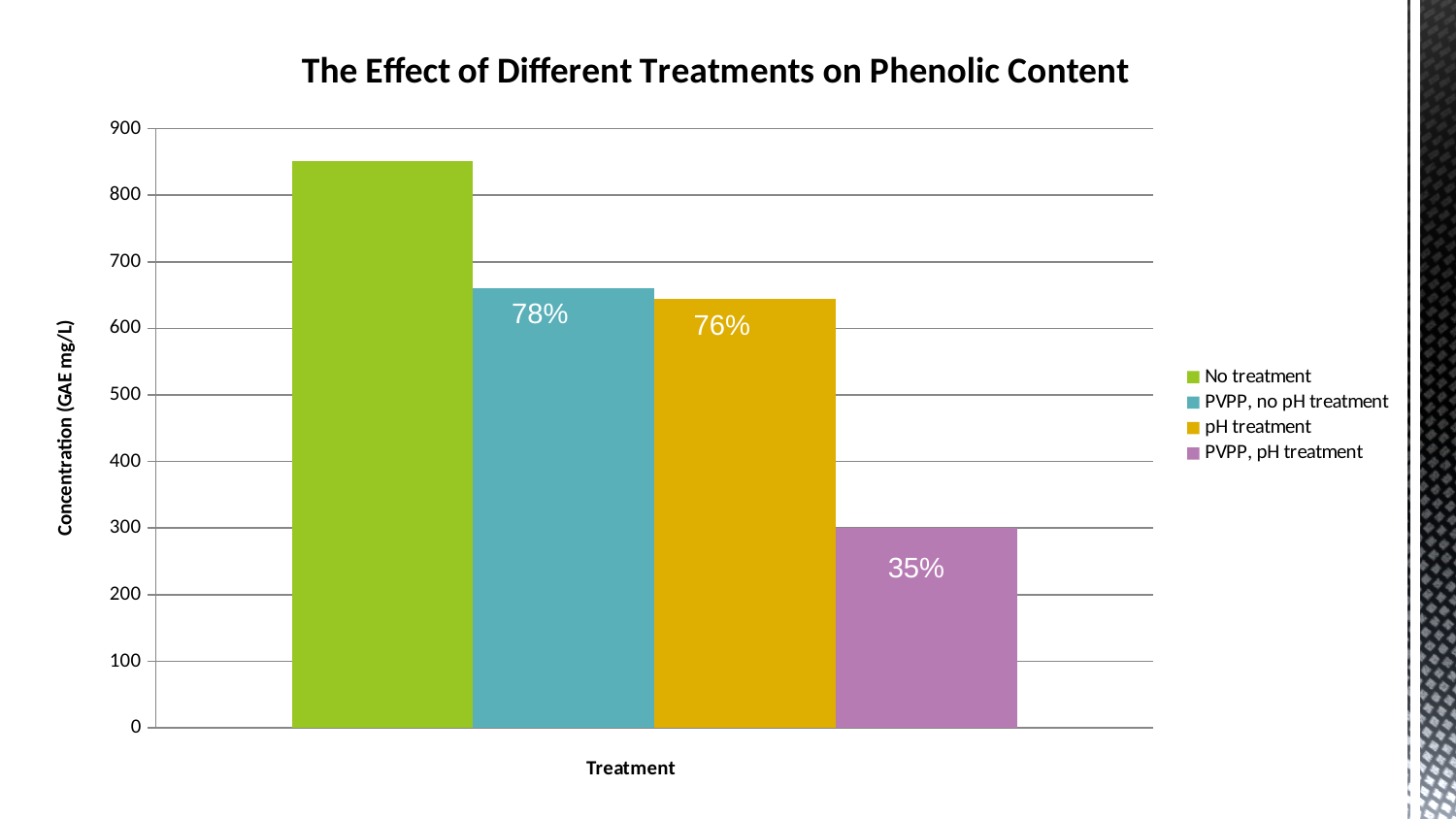
Is the concentration for No treatment greater or less than 800? greater How many entries does the legend list? 4 Which treatment has the lowest phenolic concentration? PVPP, pH treatment Is the concentration for PVPP, pH treatment greater or less than 400? less What label is printed on the PVPP, no pH treatment bar? 78% What is the title of the chart? The Effect of Different Treatments on Phenolic Content What kind of chart is shown on the slide? bar chart What label is printed on the pH treatment bar? 76% How many treatment categories are plotted in the chart? 4 What label is printed on the PVPP, pH treatment bar? 35% Which treatment has the highest phenolic concentration? No treatment Which has a higher concentration: No treatment or PVPP, pH treatment? No treatment